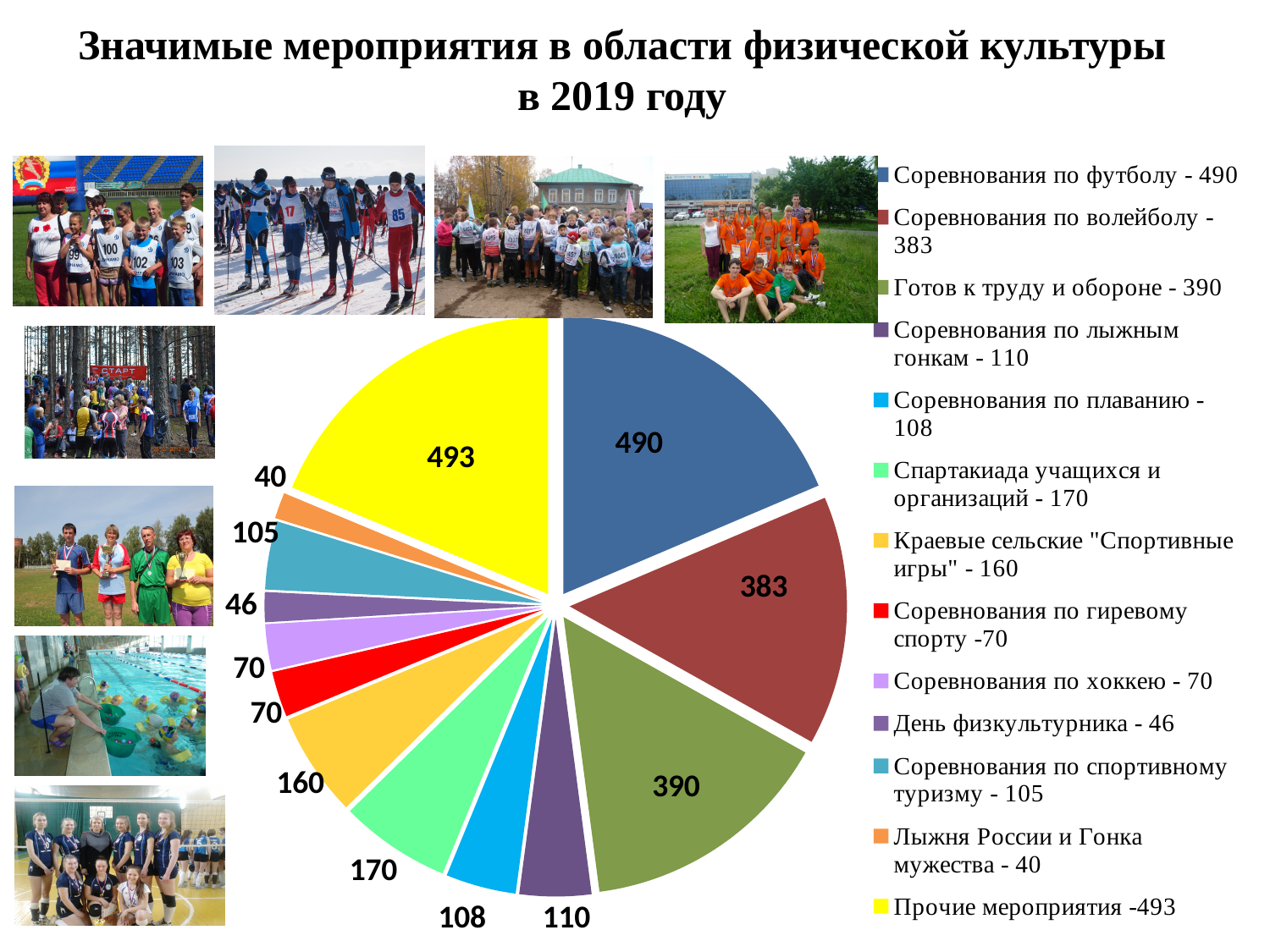
Which is larger: "Спартакиада учащихся и организаций" or "Краевые сельские "Спортивные игры""? Спартакиада учащихся и организаций What is the value for "Готов к труду и обороне"? 390 What is the title of the slide containing the pie chart? Значимые мероприятия в области физической культуры в 2019 году What is the difference between the values for "Соревнования по лыжным гонкам" and "Соревнования по плаванию"? 2 What is the value for "Соревнования по спортивному туризму"? 105 Which category has the largest value in the pie chart? Прочие мероприятия What colour is the slice for "Прочие мероприятия"? yellow What kind of chart is shown on the slide? pie chart Which category has the smallest value in the pie chart? Лыжня России и Гонка мужества How many categories does the pie chart have? 13 What is the difference between the values for "Соревнования по футболу" and "Соревнования по волейболу"? 107 What is the value for "Соревнования по футболу"? 490